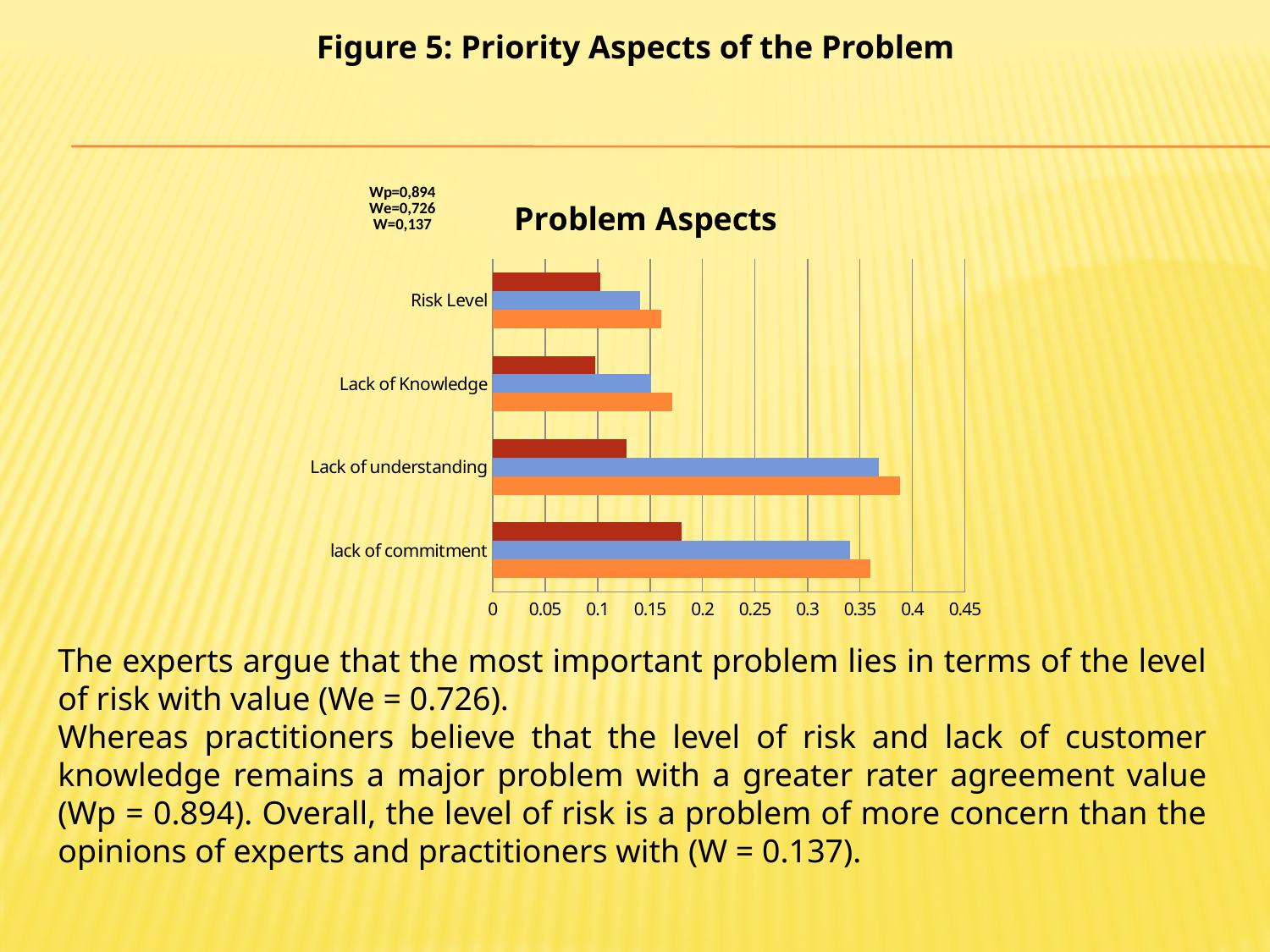
Is the blue bar for lack of commitment greater or less than 0.3? greater Which category has the shortest blue bar? Risk Level Which category has the longest orange bar? Lack of understanding Is the orange bar for Lack of understanding greater or less than 0.35? greater How many categories are listed on the vertical axis of the Problem Aspects chart? 4 Is the dark red bar for Risk Level greater or less than 0.15? less What is the title of the chart? Problem Aspects What kind of chart is shown on the slide? bar chart How many bars (series) are shown for each category in the chart? 3 What is the highest value shown on the horizontal axis of the chart? 0.45 Which category has the longest dark red bar? lack of commitment Which is larger: the blue bar for Lack of understanding or the blue bar for Lack of Knowledge? Lack of understanding